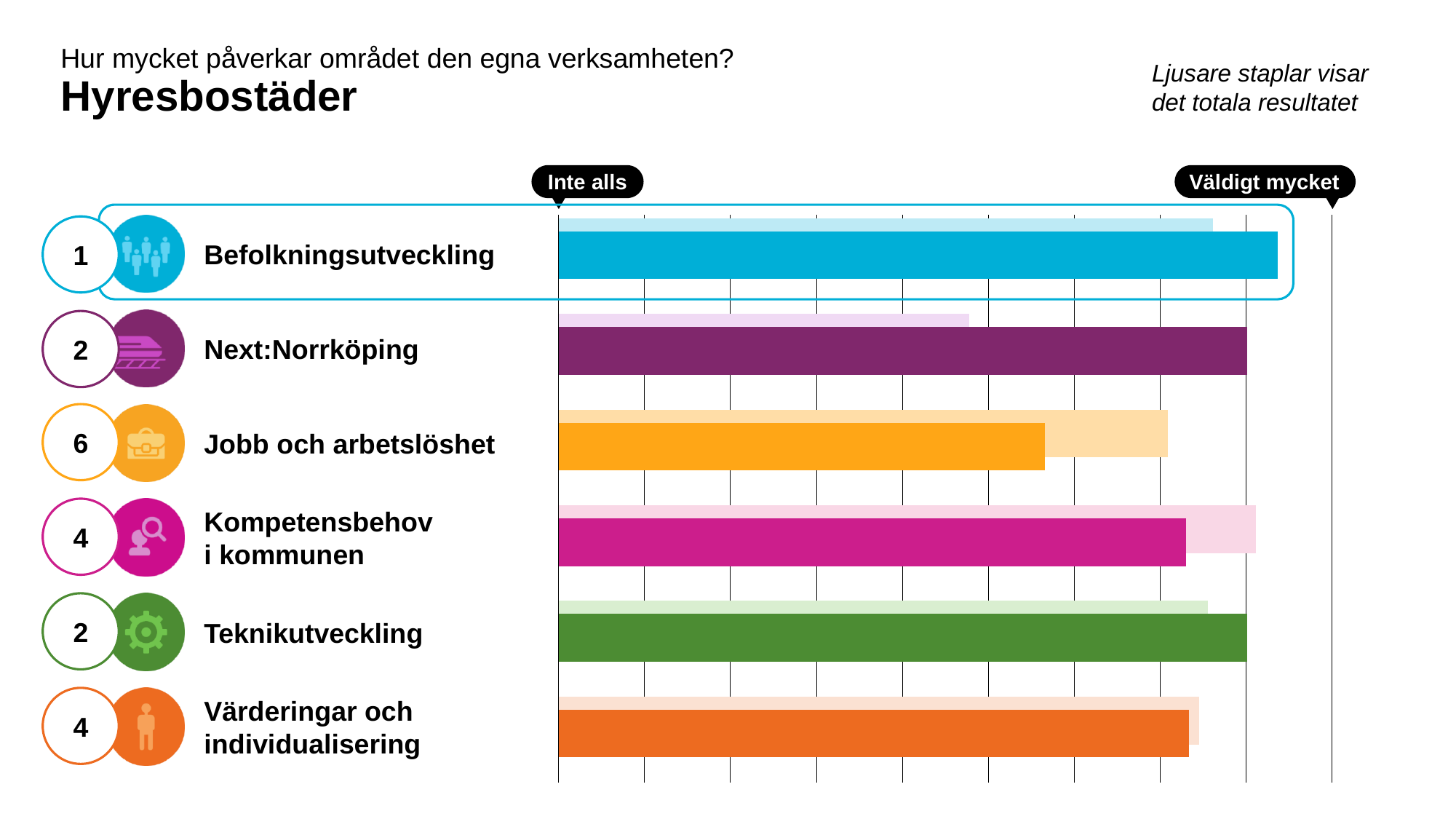
Which category has the shortest light bar (total result)? Next:Norrköping Which dark bar is longer: Next:Norrköping or Jobb och arbetslöshet? Next:Norrköping For Jobb och arbetslöshet, which bar is longer: the dark bar or the light bar? the light bar How many categories (areas) are shown in the chart? 6 According to the note on the slide, what do the lighter bars show? det totala resultatet Which dark bar is longer: Teknikutveckling or Kompetensbehov i kommunen? Teknikutveckling Which category has the longest light bar (total result)? Kompetensbehov i kommunen What is the bold title of the slide? Hyresbostäder What kind of chart is shown on the slide? bar chart Which category has the longest dark bar? Befolkningsutveckling Which category has the shortest dark bar? Jobb och arbetslöshet